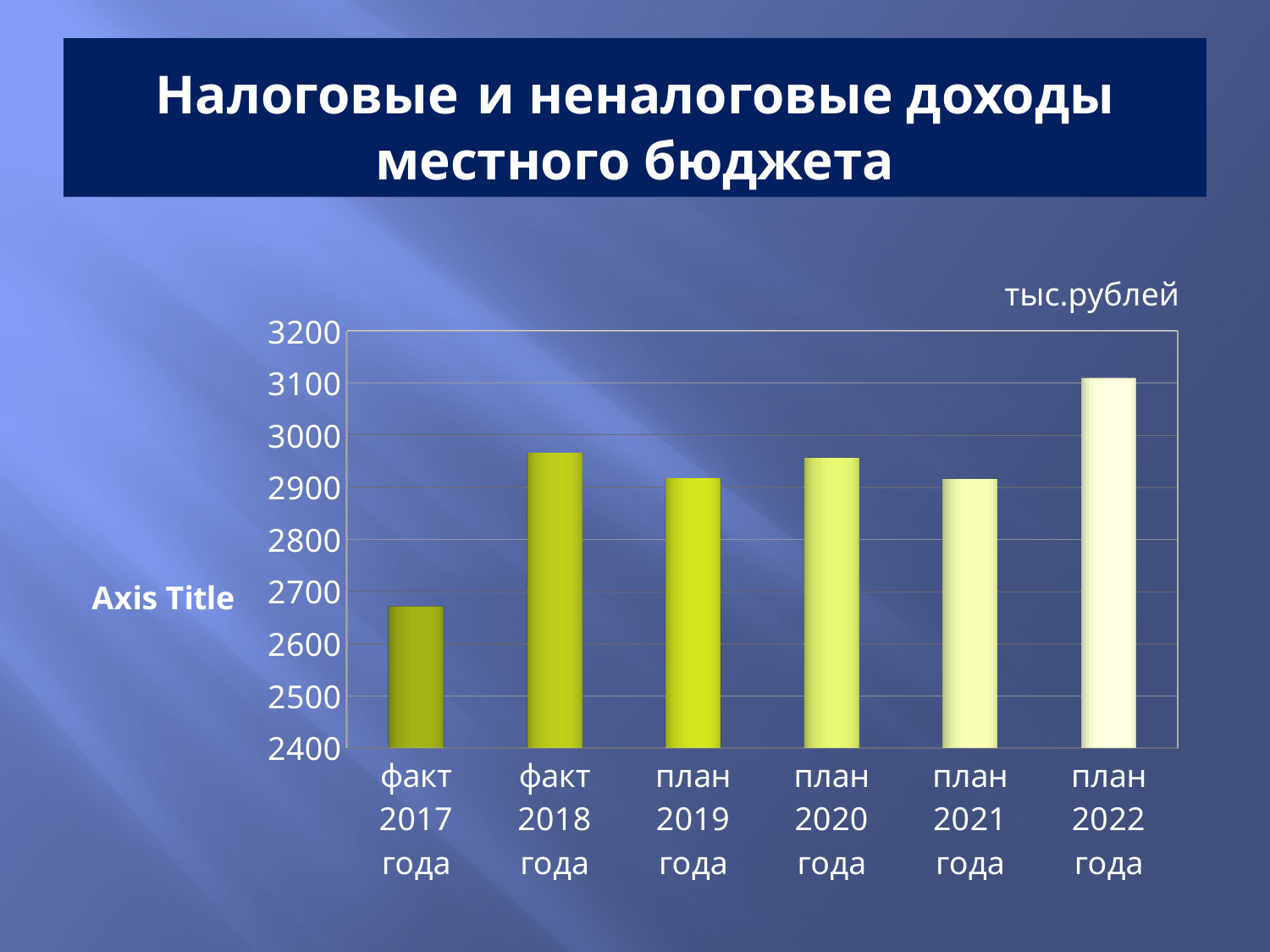
Is the value for факт 2017 года greater or less than 2700? less How many categories (bars) are shown on the chart? 6 What kind of chart is shown on the slide? bar chart Which is larger, the value for факт 2017 года or the value for план 2022 года? план 2022 года Is the value for факт 2018 года greater or less than 3000? less Is the value for план 2022 года greater or less than 3000? greater What unit is indicated above the chart? тыс.рублей What is the title of the slide's chart? Налоговые и неналоговые доходы местного бюджета Which category has the highest value? план 2022 года Which category has the lowest value? факт 2017 года